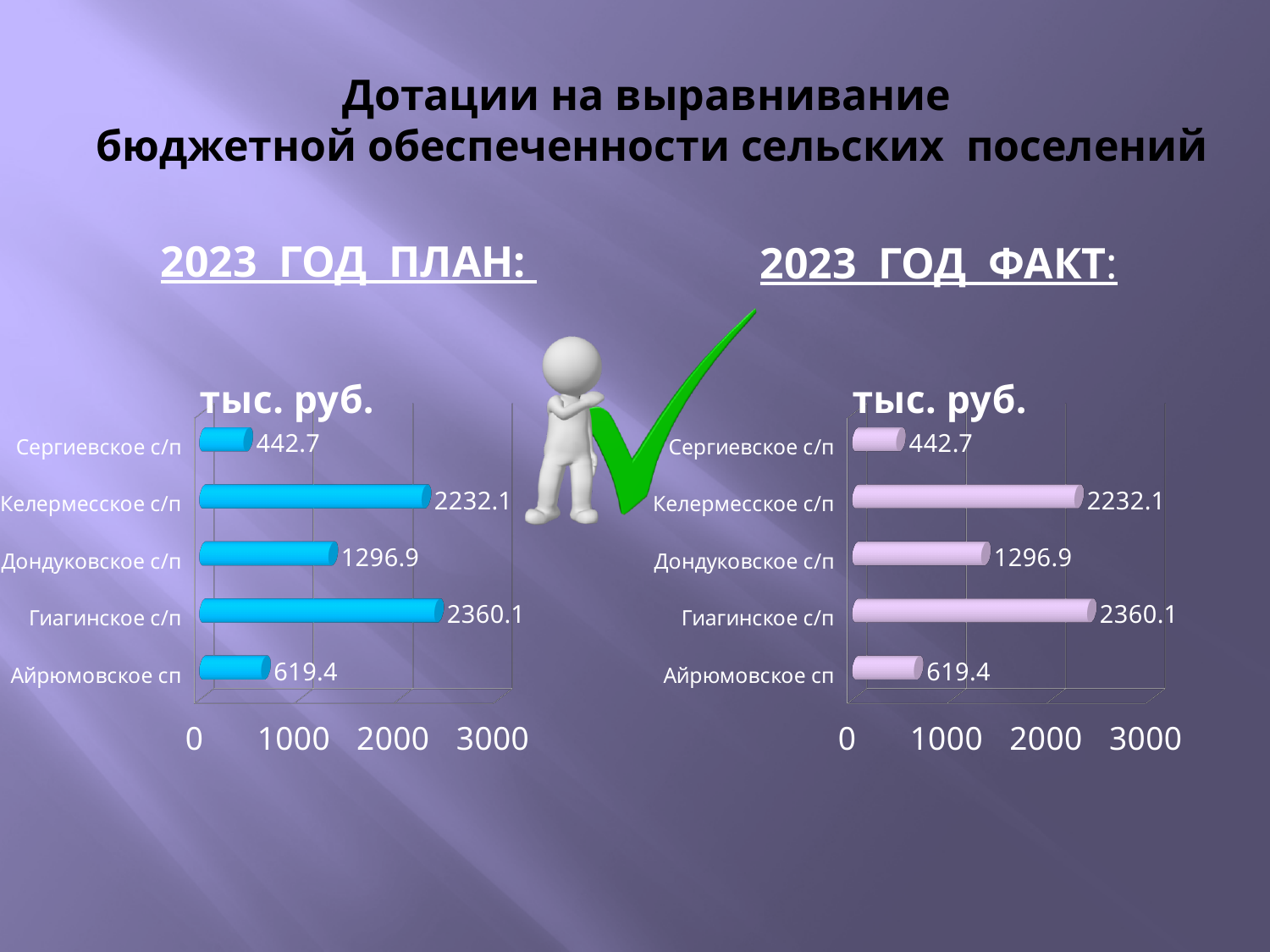
In the right chart (2023 ГОД ФАКТ), which category has the lowest value? Сергиевское с/п In the left chart (2023 ГОД ПЛАН), which category has the highest value? Гиагинское с/п In the left chart (2023 ГОД ПЛАН), what is the difference between the values for Гиагинское с/п and Келермесское с/п? 128.0 In the right chart (2023 ГОД ФАКТ), is the value for Дондуковское с/п greater or less than 1000? greater What is the title shown above the left chart? тыс. руб. In the right chart (2023 ГОД ФАКТ), what is the value for Айрюмовское сп? 619.4 In the right chart (2023 ГОД ФАКТ), what is the difference between the values for Дондуковское с/п and Айрюмовское сп? 677.5 In the left chart (2023 ГОД ПЛАН), which is larger: the value for Дондуковское с/п or the value for Сергиевское с/п? Дондуковское с/п How many categories are shown in the left chart (2023 ГОД ПЛАН)? 5 In the left chart (2023 ГОД ПЛАН), what is the value for Келермесское с/п? 2232.1 What colour are the bars in the left chart (2023 ГОД ПЛАН)? blue What kind of chart is the right chart (2023 ГОД ФАКТ)? bar chart